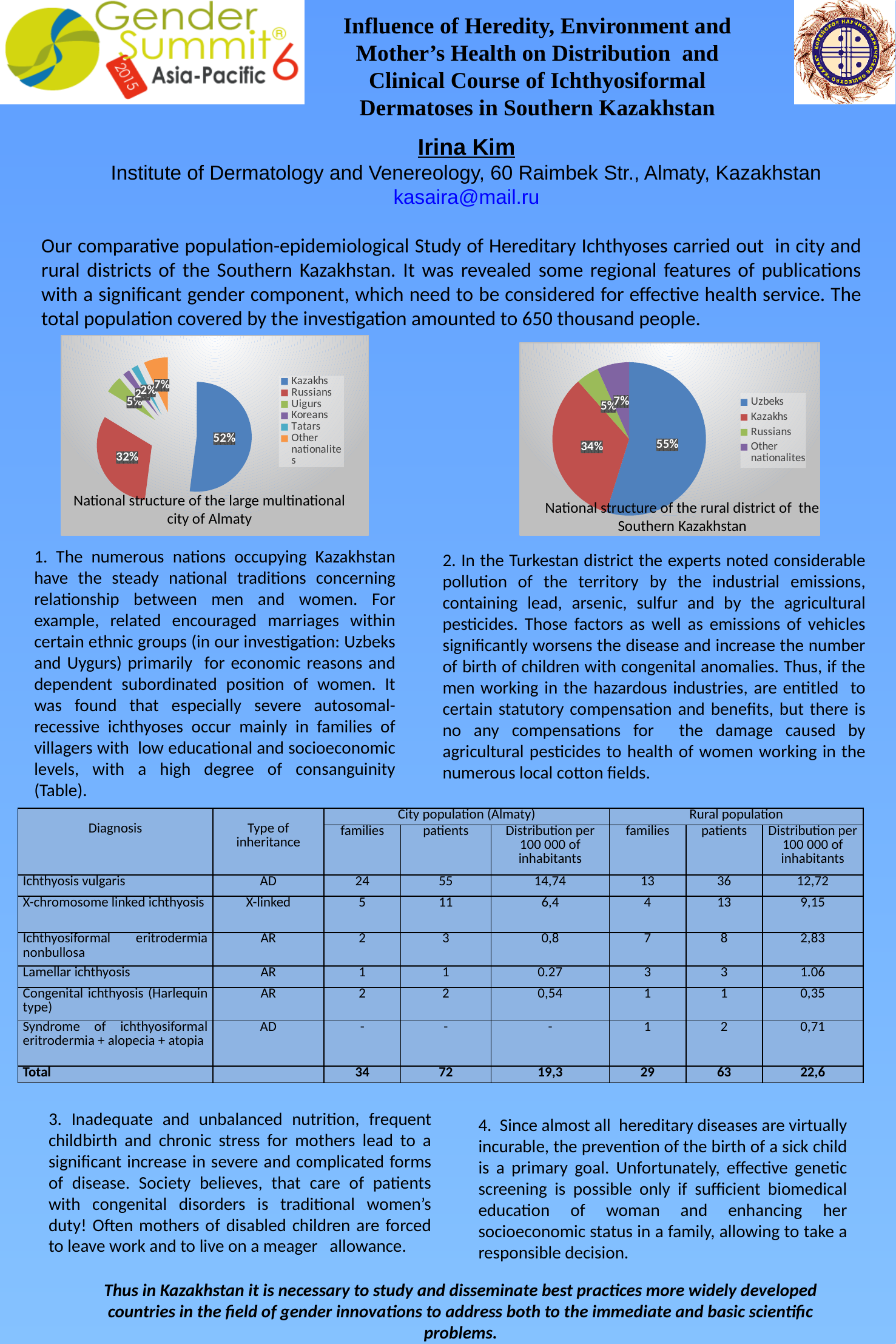
In the chart titled 'National structure of the rural district of the Southern Kazakhstan', what share do Russians have? 5% In the chart titled 'National structure of the rural district of the Southern Kazakhstan', which is larger, the share of Uzbeks or the share of Kazakhs? Uzbeks In the chart titled 'National structure of the rural district of the Southern Kazakhstan', what share do Uzbeks have? 55% In the chart titled 'National structure of the large multinational city of Almaty', what share do Russians have? 32% In the chart titled 'National structure of the large multinational city of Almaty', what share do Kazakhs have? 52% What kind of chart is 'National structure of the large multinational city of Almaty'? Pie chart In the chart titled 'National structure of the large multinational city of Almaty', how many categories does the legend list? 6 In the chart titled 'National structure of the rural district of the Southern Kazakhstan', how many categories does the legend list? 4 In the chart titled 'National structure of the large multinational city of Almaty', what is the difference between the Kazakhs and Russians shares? 20% In the chart titled 'National structure of the large multinational city of Almaty', which nationality has the largest share? Kazakhs In the chart titled 'National structure of the rural district of the Southern Kazakhstan', which nationality has the smallest share? Russians In the chart titled 'National structure of the rural district of the Southern Kazakhstan', what share do Kazakhs have? 34%